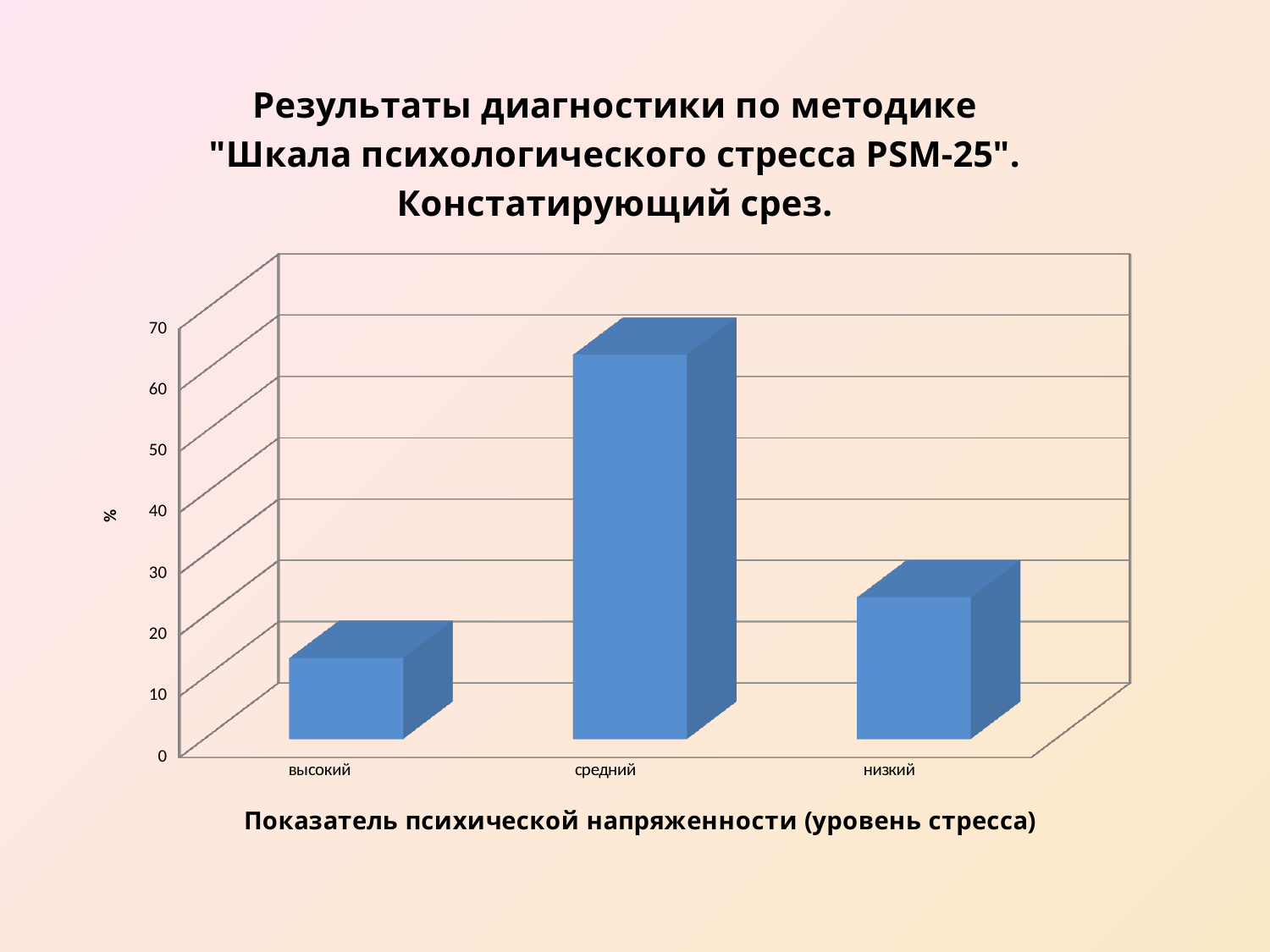
How many categories are shown on the x axis of the chart? 3 Which is larger, the value for низкий or the value for высокий? низкий What kind of chart is shown on the slide? bar chart What is the label of the vertical axis of the chart? % Is the value for средний greater or less than 50? greater Is the value for низкий greater or less than 30? less Which category has the highest value in the chart? средний Which is larger, the value for средний or the value for низкий? средний What is the title of the horizontal axis of the chart? Показатель психической напряженности (уровень стресса) Is the value for низкий greater or less than 20? greater Which category has the lowest value in the chart? высокий